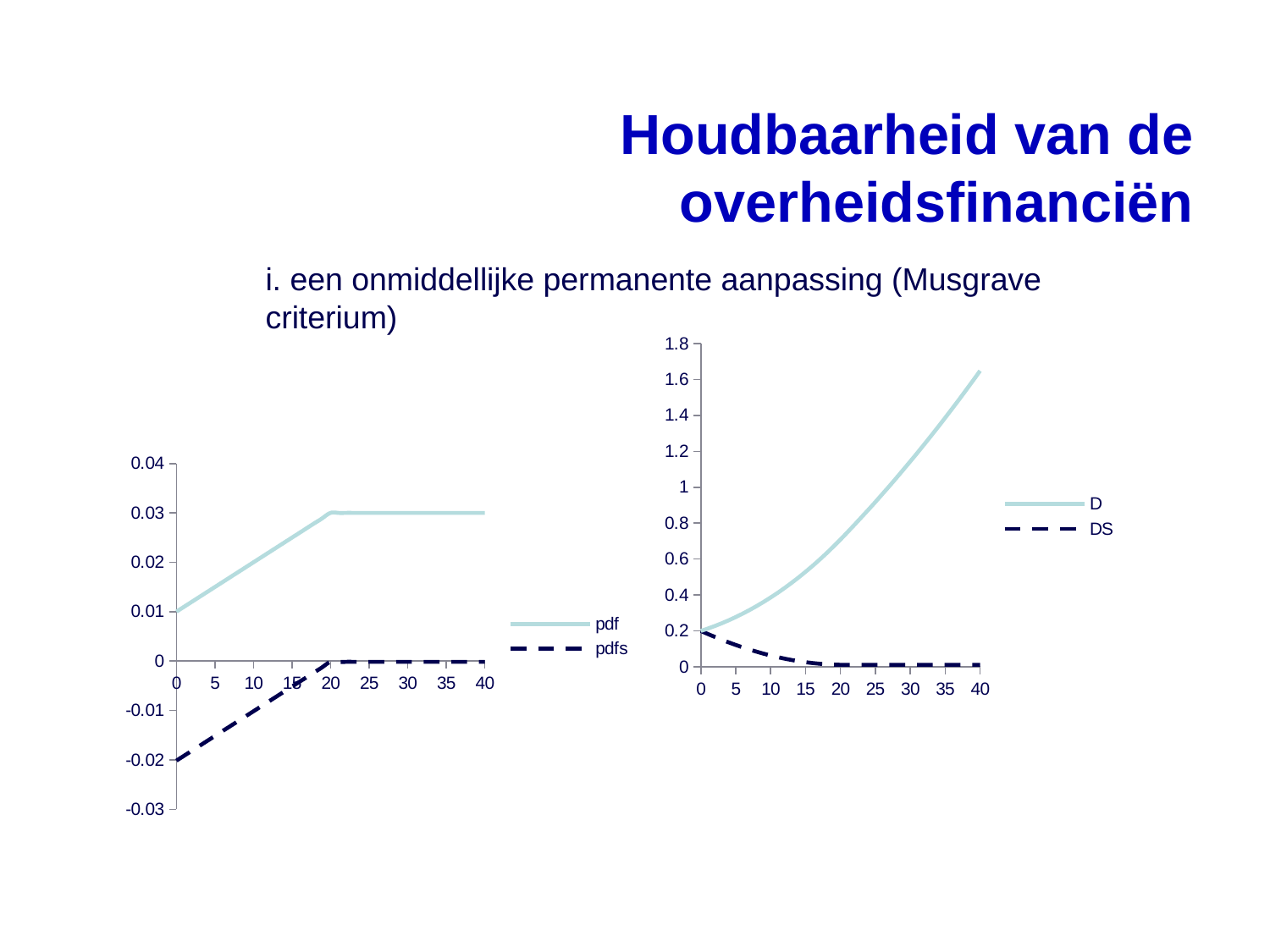
In the right chart, which series has the larger value at x = 40, D or DS? D In the right chart, does the DS series rise or fall along the x axis? fall In the right chart, is the value of D at x = 40 greater or less than 1.4? greater In the left chart, what is the value of pdf at x = 0? 0.01 How many series does the legend of the left chart list? 2 In the left chart, is the value of pdfs at x = 10 greater or less than 0? less In the left chart, what is the value of pdf at x = 40? 0.03 What kind of chart is the left chart (with pdf and pdfs)? line chart In the left chart, what is the value of pdfs at x = 0? -0.02 In the left chart, does the pdf series rise or fall between x = 0 and x = 20? rise In the right chart, what is the value of D at x = 0? 0.2 What are the legend entries of the right chart? D and DS